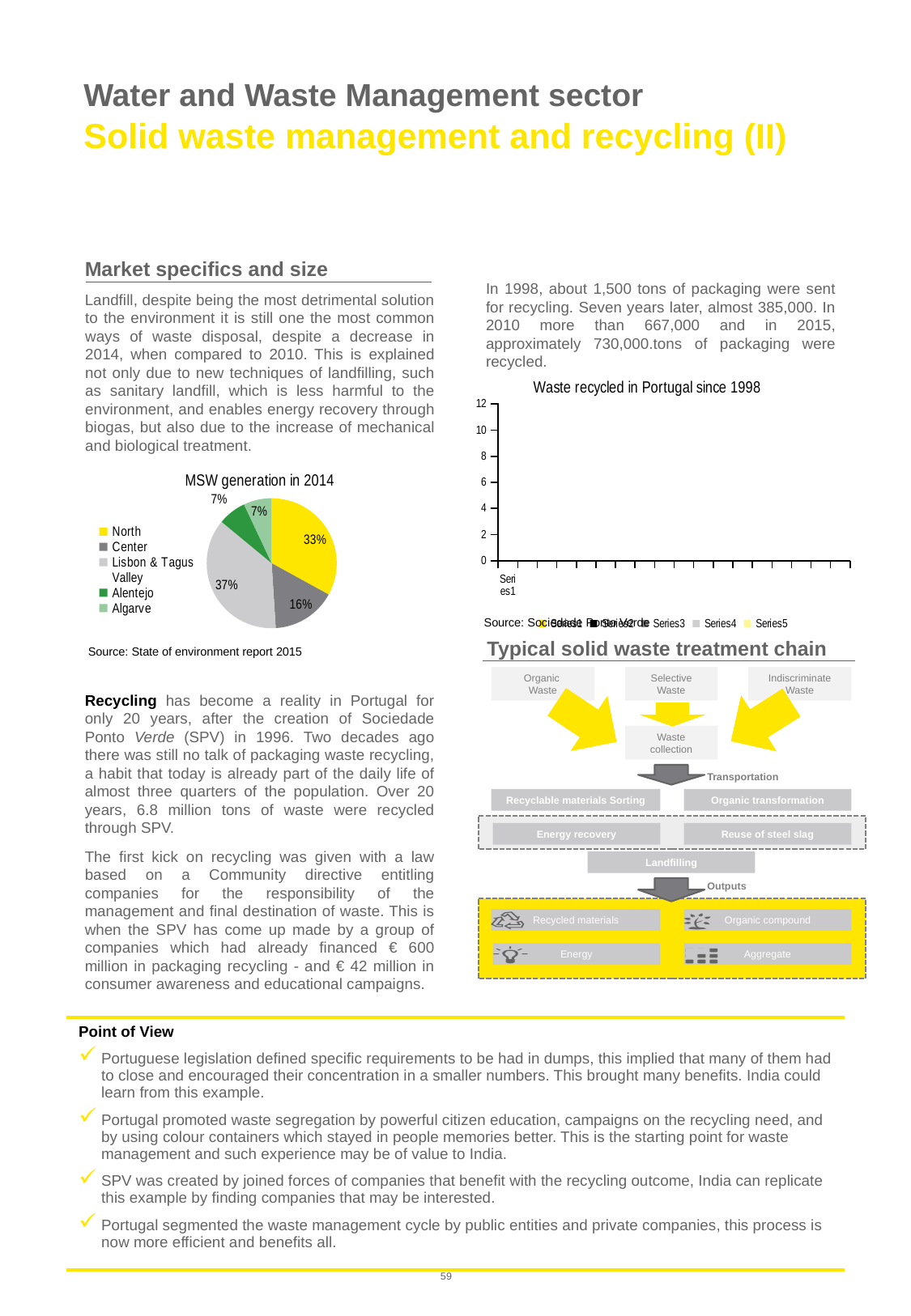
What is the title of the pie chart on the left side of the slide? MSW generation in 2014 In the MSW generation in 2014 pie chart, what is the combined share of Alentejo and Algarve? 14% In the MSW generation in 2014 pie chart, which region has the largest share? Lisbon & Tagus Valley What is the title of the chart on the right side of the slide, above the treatment chain diagram? Waste recycled in Portugal since 1998 In the MSW generation in 2014 pie chart, which is larger, the share for North or the share for Lisbon & Tagus Valley? Lisbon & Tagus Valley In the MSW generation in 2014 pie chart, what share does the Center region have? 16% How many regions are shown in the MSW generation in 2014 pie chart? 5 In the MSW generation in 2014 pie chart, what is the difference in percentage points between Lisbon & Tagus Valley and Center? 21 percentage points In the MSW generation in 2014 pie chart, what share does the North region have? 33% In the MSW generation in 2014 pie chart, what is the difference in percentage points between North and Center? 17 percentage points In the MSW generation in 2014 pie chart, what share does Lisbon & Tagus Valley have? 37% What kind of chart is the MSW generation in 2014 chart? Pie chart